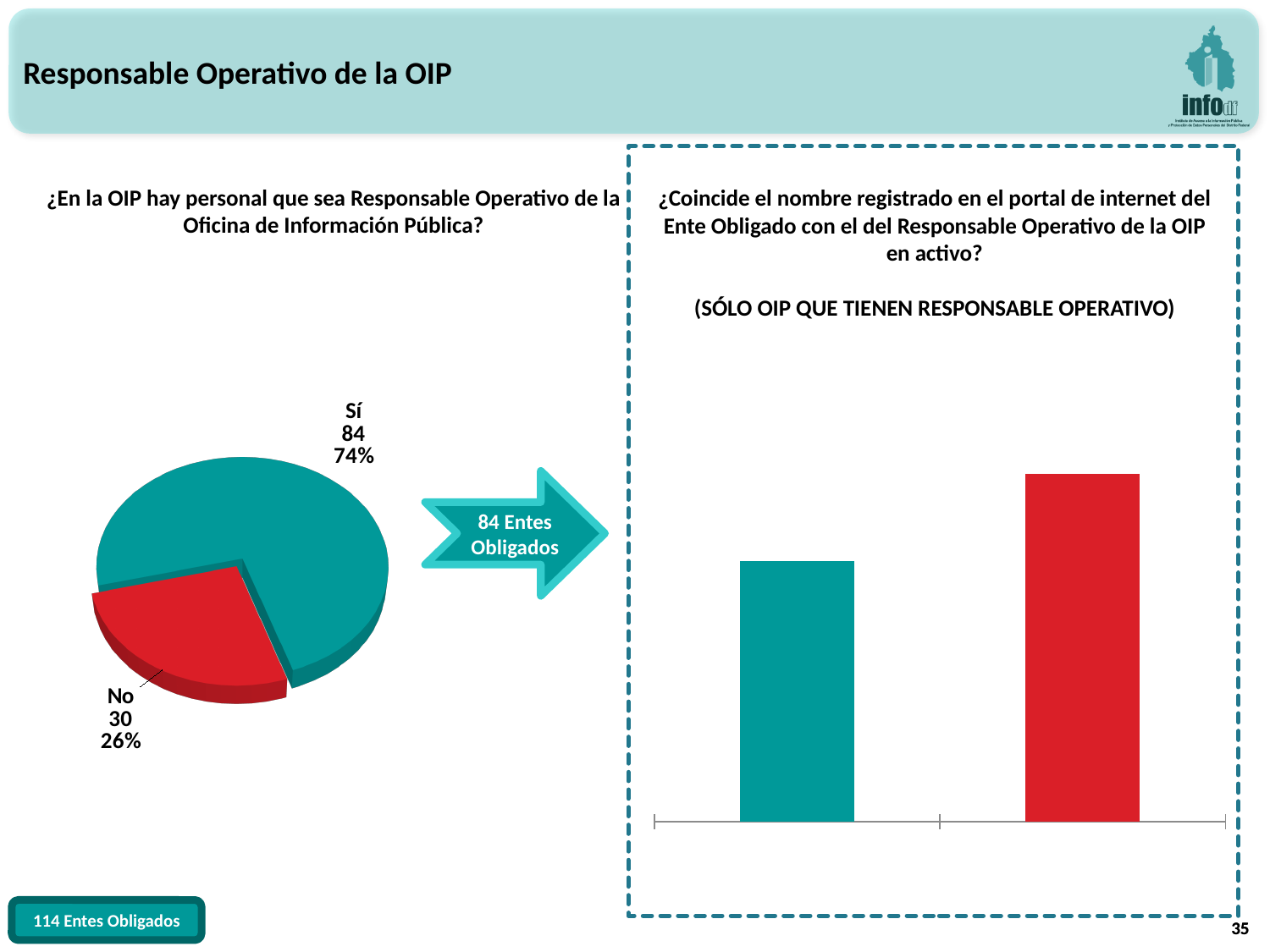
In the pie chart on the left, what is the difference between the number of "Sí" and "No" responses? 54 In the pie chart on the left, what share of the pie does the "Sí" slice represent? 74% What kind of chart is shown inside the dashed box on the right side of the slide? Bar chart In the pie chart on the left, how many slices are there? 2 In the pie chart on the left, how many Entes Obligados answered "Sí"? 84 In the bar chart on the right, how many bars are plotted? 2 In the pie chart on the left, which category has the largest slice? Sí In the pie chart on the left, what share of the pie does the "No" slice represent? 26% What kind of chart is shown on the left side of the slide? Pie chart In the pie chart on the left, which category has the smallest slice? No In the pie chart on the left, how many Entes Obligados answered "No"? 30 In the bar chart on the right, which bar is taller, the teal one or the red one? The red one